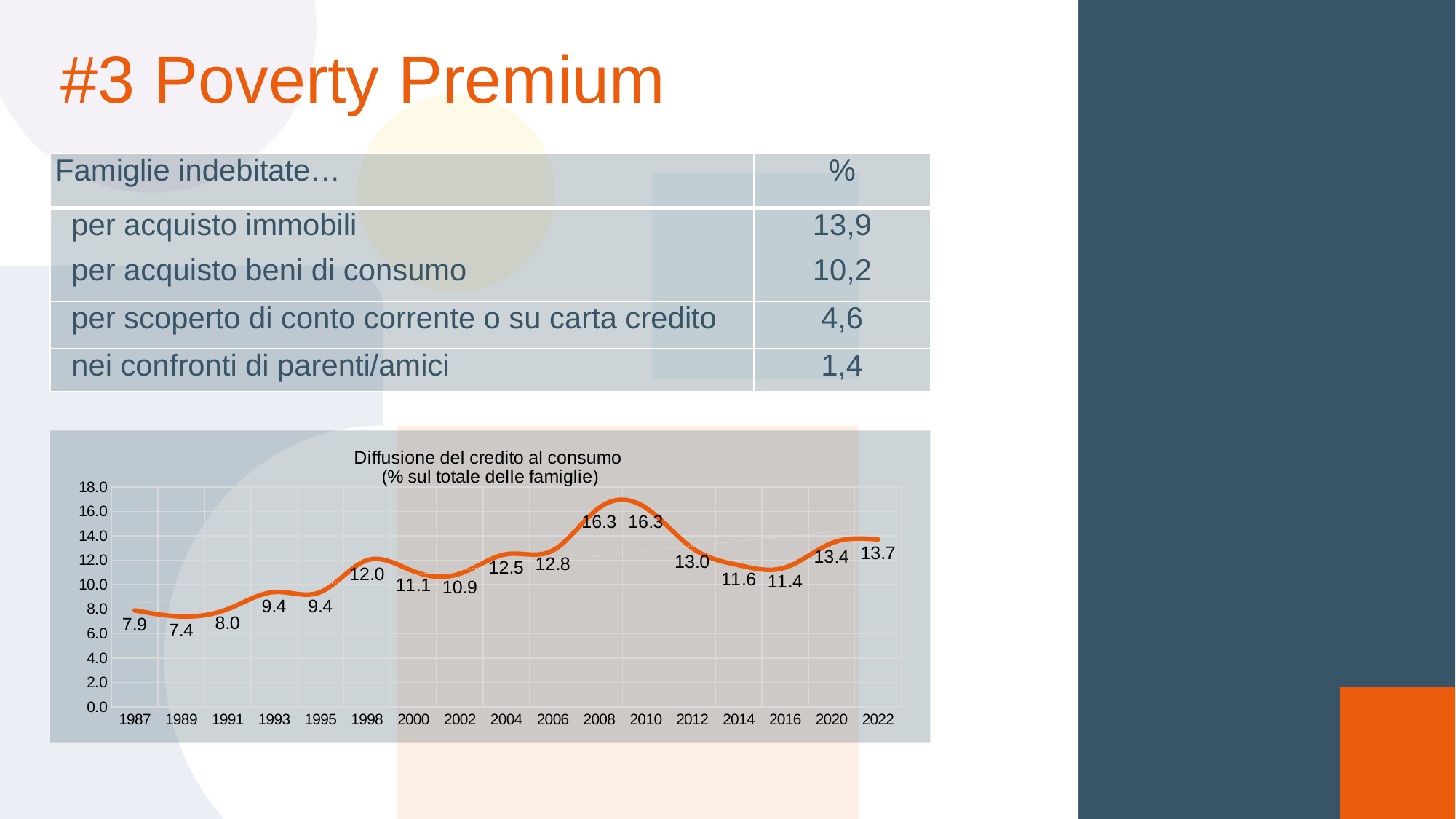
What type of chart is shown on the slide? line chart What is the value for 2012 in the chart? 13.0 What is the value for 1987 in the chart? 7.9 What is the value for 2022 in the chart? 13.7 What is the value for 1998 in the chart? 12.0 What is the difference between the values for 2010 and 2012? 3.3 Does the value rise or fall from 1987 to 1998? rise Which year has the larger value, 2006 or 2016? 2006 Which year has the lowest value in the chart? 1989 How many years are plotted on the x axis of the chart? 17 What is the title of the chart? Diffusione del credito al consumo (% sul totale delle famiglie) What is the highest value plotted in the chart? 16.3